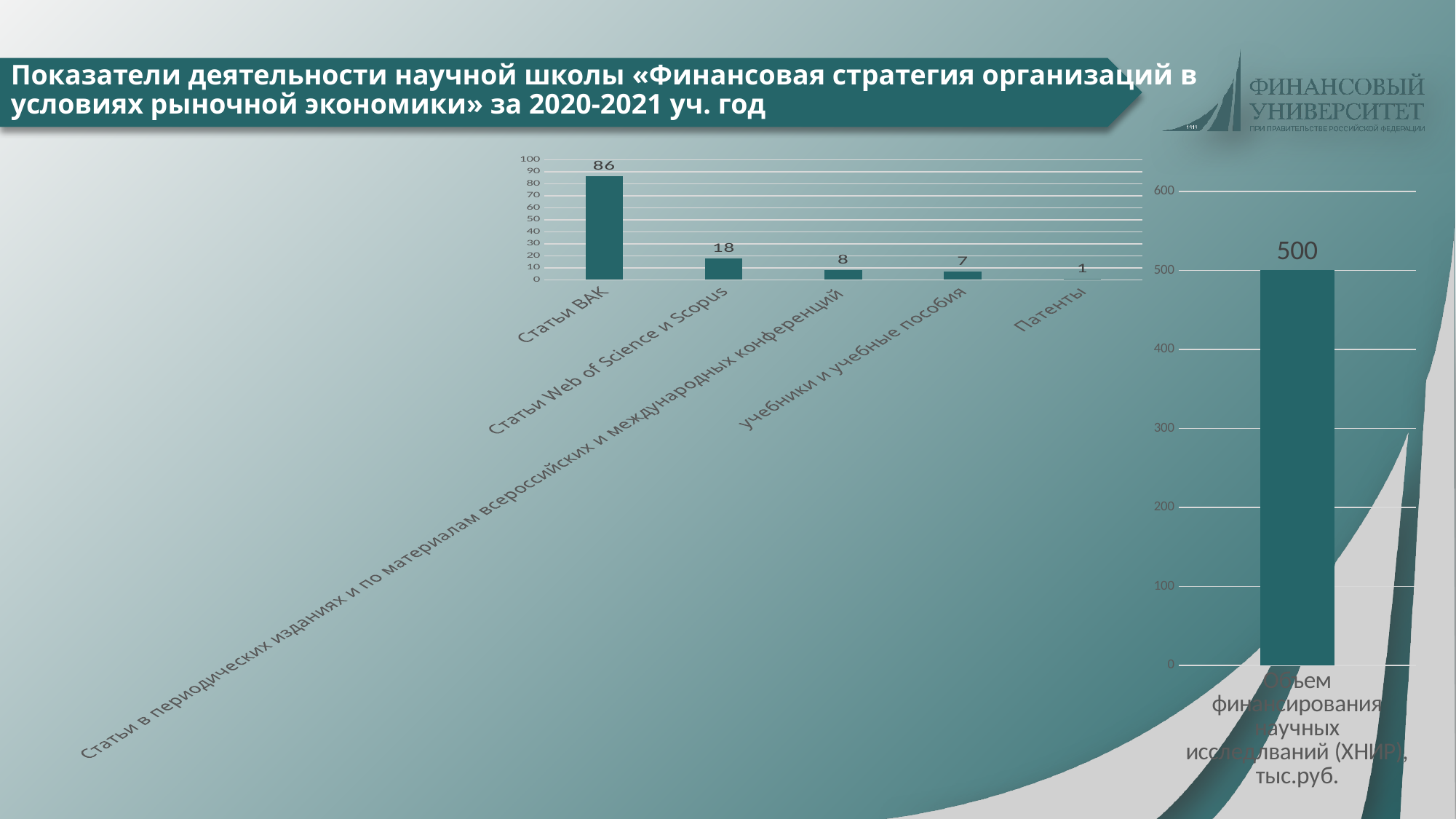
On the left chart, how many categories are shown? 5 On the left chart, what is the value for Статьи ВАК? 86 What kind of chart is the left chart? bar chart On the left chart, what is the difference between the values for Статьи ВАК and Статьи Web of Science и Scopus? 68 On the right chart, what is the value for Объем финансирования научных исследований (ХНИР), тыс.руб.? 500 On the left chart, which category has the highest value? Статьи ВАК On the left chart, what is the value for Патенты? 1 On the left chart, what is the value for учебники и учебные пособия? 7 On the left chart, which is larger: the value for Статьи Web of Science и Scopus or the value for учебники и учебные пособия? Статьи Web of Science и Scopus On the left chart, which category has the lowest value? Патенты On the right chart, how many bars are shown? 1 On the left chart, what is the value for Статьи Web of Science и Scopus? 18